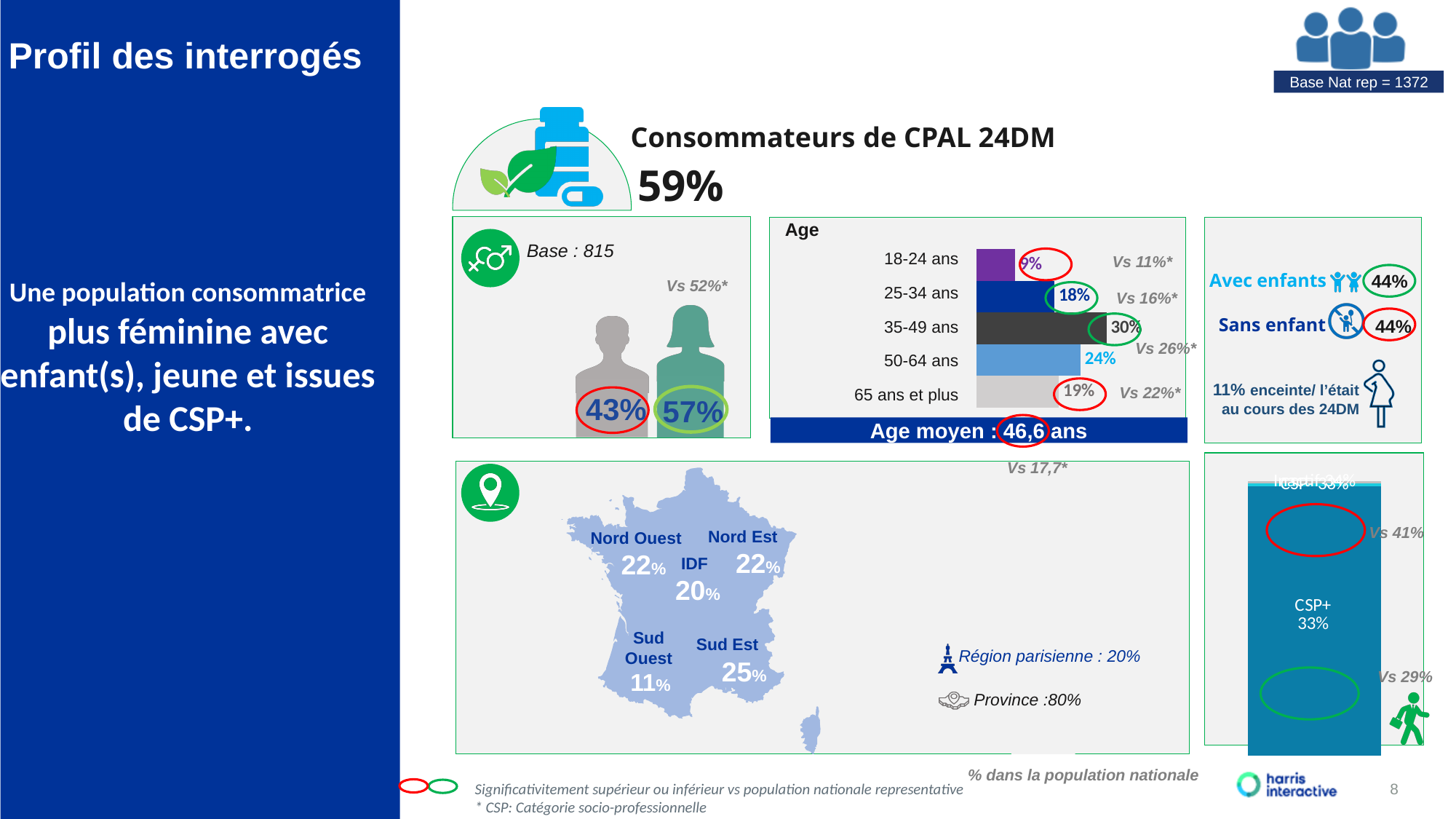
What type of chart is the Age chart? bar chart In the Age chart, what is the difference in percentage points between the 35-49 ans and 18-24 ans categories? 21 In the Age chart, what percentage is shown for the 18-24 ans category? 9% In the Age chart, what percentage is shown for the 65 ans et plus category? 19% In the stacked bar chart on the right of the slide, what percentage is shown for CSP+? 33% In the Age chart, which is larger: the value for 50-64 ans or for 65 ans et plus? 50-64 ans In the Age chart, which age category has the lowest percentage? 18-24 ans In the Age chart, what percentage is shown for the 35-49 ans category? 30% What is the title of the chart showing the age breakdown? Age In the Age chart, which age category has the highest percentage? 35-49 ans How many age categories are plotted in the Age chart? 5 In the Age chart, what percentage is shown for the 25-34 ans category? 18%